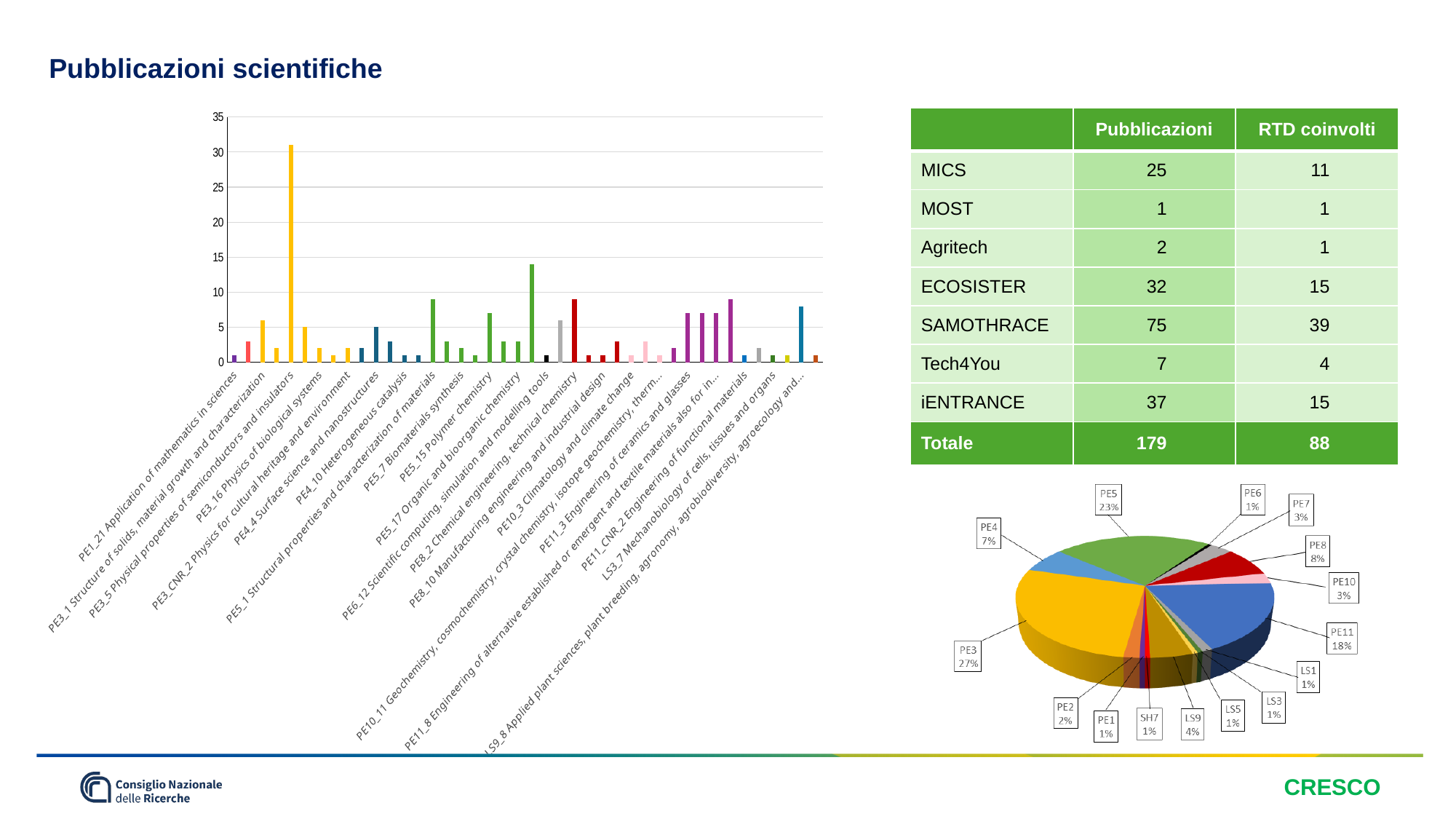
In the pie chart, what share does PE11 have? 18% In the pie chart, what share does LS9 have? 4% What is the highest value shown on the vertical axis of the bar chart on the left? 35 What kind of chart is shown on the left side of the slide? bar chart How many slices are labelled in the pie chart? 15 In the pie chart, what share does PE3 have? 27% What kind of chart is shown at the bottom right of the slide? pie chart In the pie chart, which is larger, PE11 or PE8? PE11 In the pie chart, what is the difference in percentage points between PE3 and PE5? 4 In the pie chart, what share does PE5 have? 23% In the pie chart, which slice has the largest share? PE3 In the bar chart on the left, is the tallest bar greater or less than 25? greater